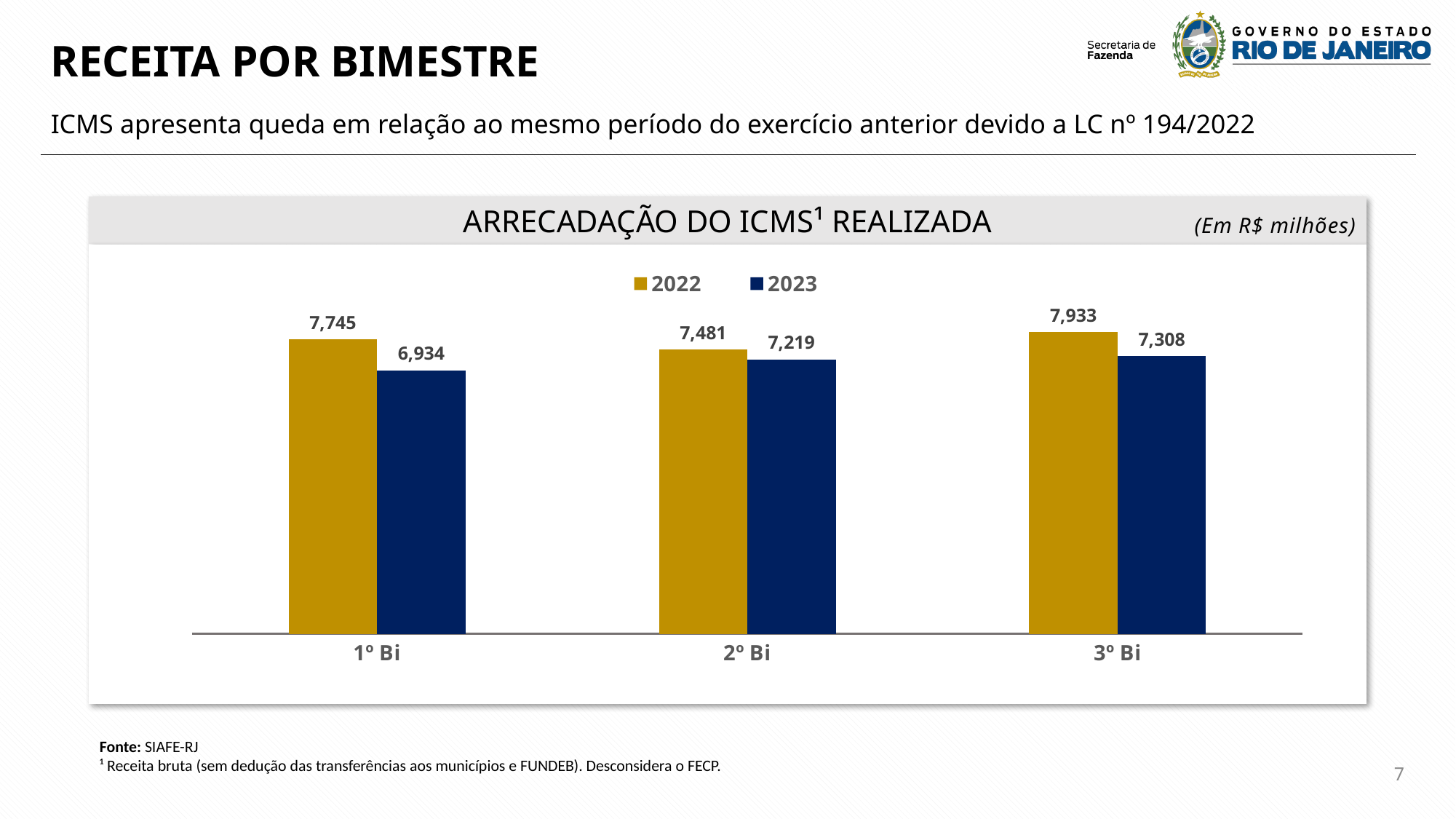
What is the 2023 value for 3º Bi? 7,308 What is the difference between the 2022 and 2023 values for 1º Bi? 811 What is the difference between the 2022 and 2023 values for 3º Bi? 625 Which bimester has the lowest 2023 value? 1º Bi What kind of chart is shown? bar chart How many series does the legend list? 2 What is the title of the chart? ARRECADAÇÃO DO ICMS¹ REALIZADA What is the 2022 value for 1º Bi? 7,745 Which bimester has the highest 2022 value? 3º Bi What is the 2023 value for 2º Bi? 7,219 Which is larger for 2º Bi, the 2022 value or the 2023 value? 2022 How many bimesters are shown on the x axis? 3